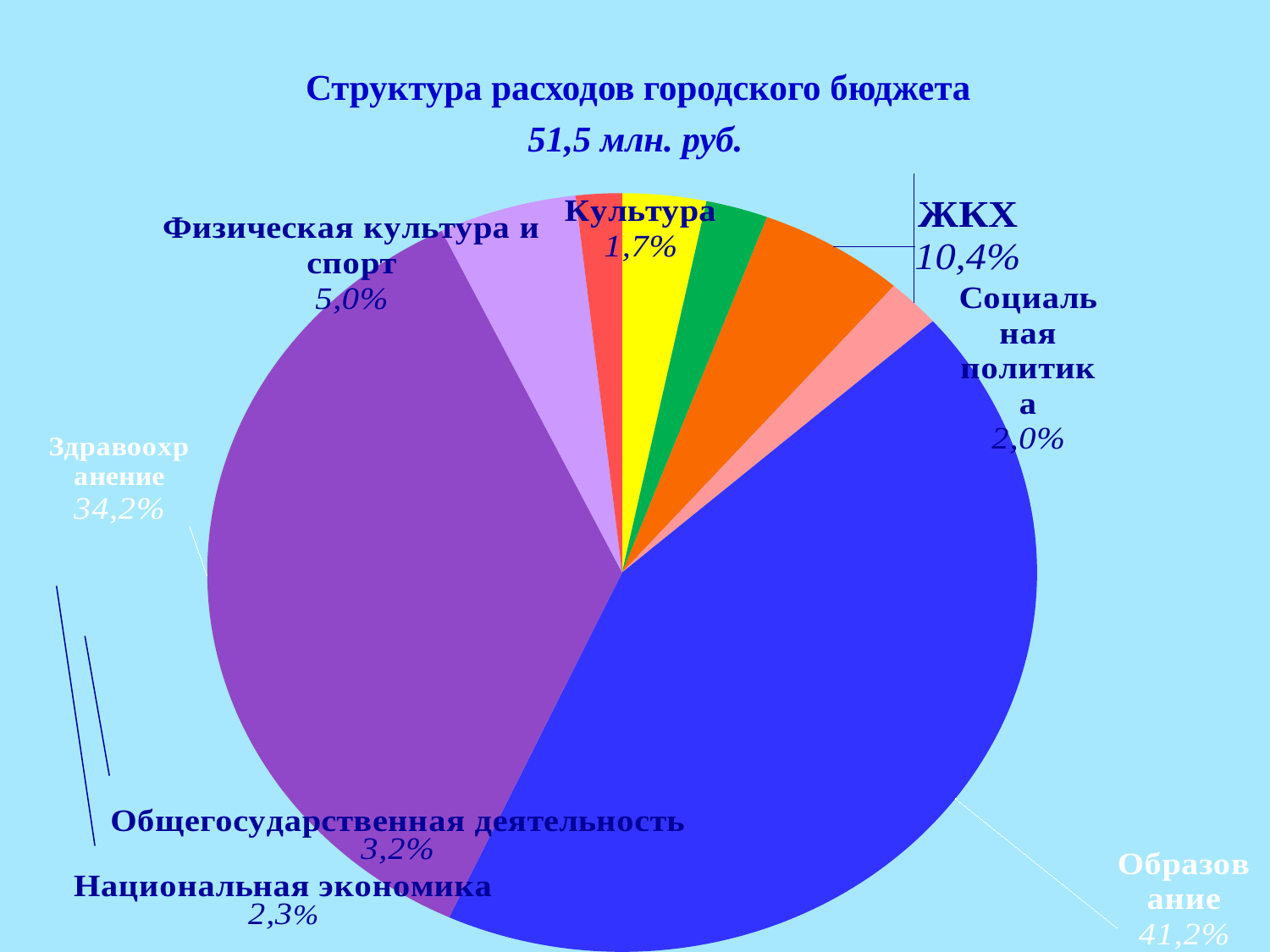
What is the title of the chart? Структура расходов городского бюджета 51,5 млн. руб. Which category has the smallest share of the budget? Культура What share of the budget goes to Образование? 41,2% What share of the budget goes to Здравоохранение? 34,2% Which category has the largest share of the budget? Образование What share of the budget goes to ЖКХ? 10,4% What kind of chart is shown on the slide? pie chart What is the combined share of Национальная экономика and Социальная политика? 4,3% How many categories are shown in the pie chart? 8 Which is larger, the share for Физическая культура и спорт or the share for Общегосударственная деятельность? Физическая культура и спорт What share of the budget goes to Культура? 1,7% What is the difference in percentage points between Образование and Здравоохранение? 7,0